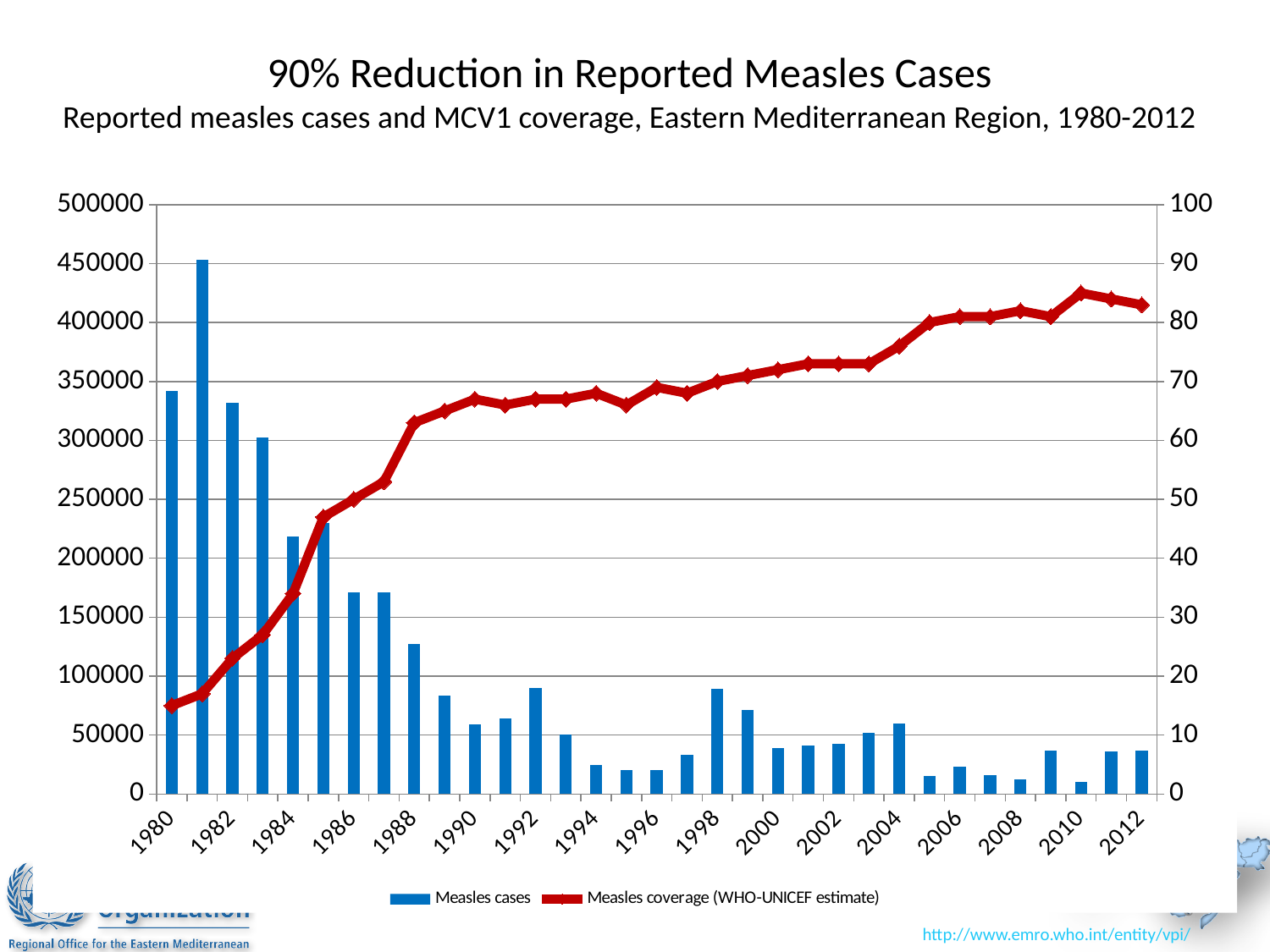
How many series does the legend list? 2 Which year has more reported measles cases, 1986 or 1988? 1986 Is the measles coverage (WHO-UNICEF estimate) in 2012 greater or less than 80? greater What kind of chart is shown on the slide? A combined bar and line chart Does the measles coverage line generally rise or fall from 1980 to 2012? rise Is the measles coverage (WHO-UNICEF estimate) in 1980 greater or less than 20? less Is the number of measles cases in 1981 greater or less than 400000? greater What colour are the bars for measles cases? Blue How many years are plotted on the x axis? 33 Which year has more reported measles cases, 1998 or 2000? 1998 Which year has the highest number of reported measles cases? 1981